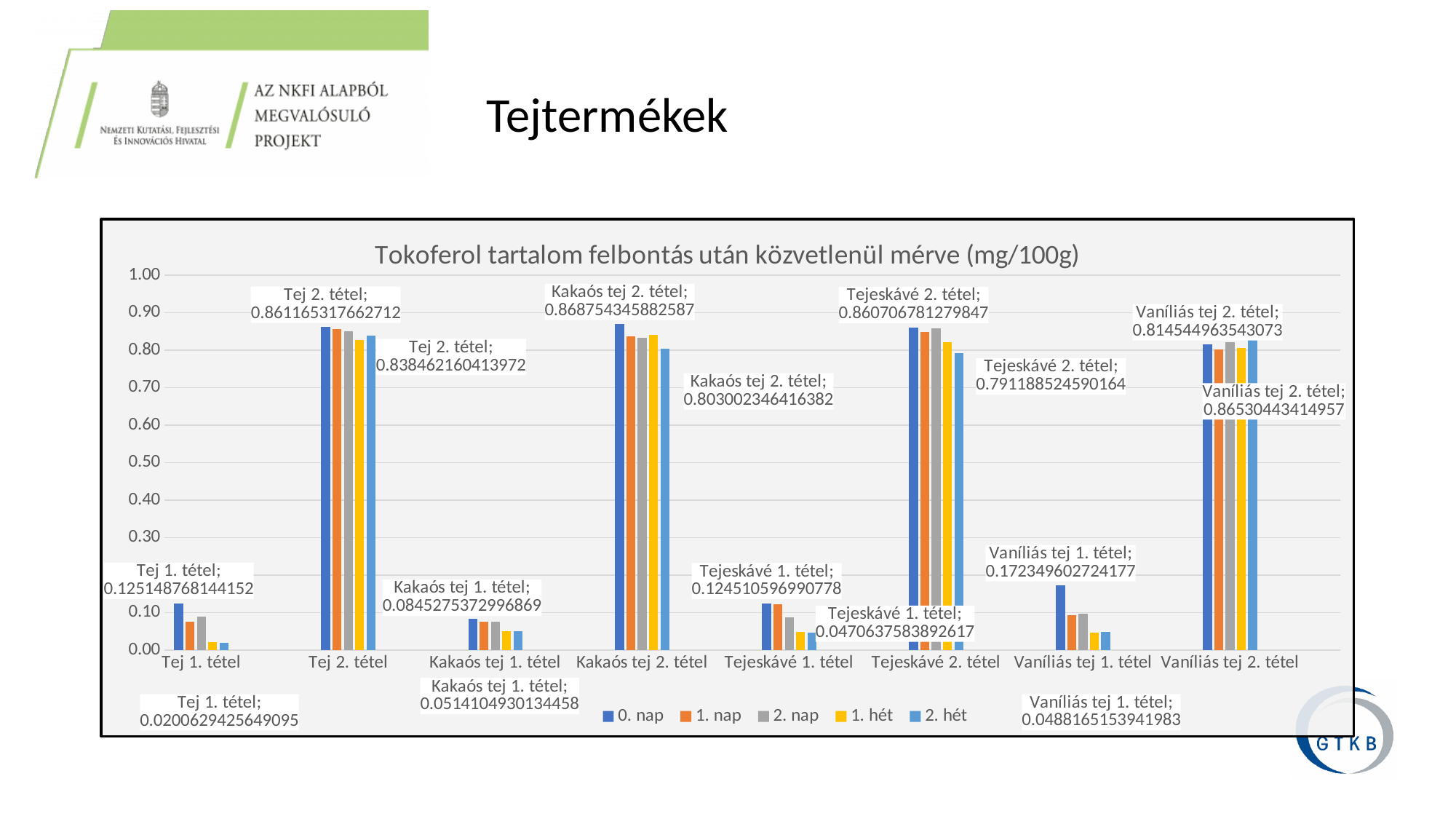
What is the highest value labelled for Tej 1. tétel? 0.125148768144152 Which category has the lowest 0. nap value? Kakaós tej 1. tétel What kind of chart is shown on the slide? bar chart How many series does the chart legend list? 5 What is the lowest value labelled for Tej 1. tétel? 0.0200629425649095 What is the title of the chart? Tokoferol tartalom felbontás után közvetlenül mérve (mg/100g) What are the series names listed in the chart legend? 0. nap, 1. nap, 2. nap, 1. hét, 2. hét Is the 2. hét value for Vaníliás tej 1. tétel greater or less than 0.10? less What is the highest value labelled for Vaníliás tej 1. tétel? 0.172349602724177 Which is larger, the 0. nap value for Tej 1. tétel or the 0. nap value for Tej 2. tétel? Tej 2. tétel Is the 0. nap value for Tej 2. tétel greater or less than 0.80? greater How many categories are shown on the x axis of the chart? 8